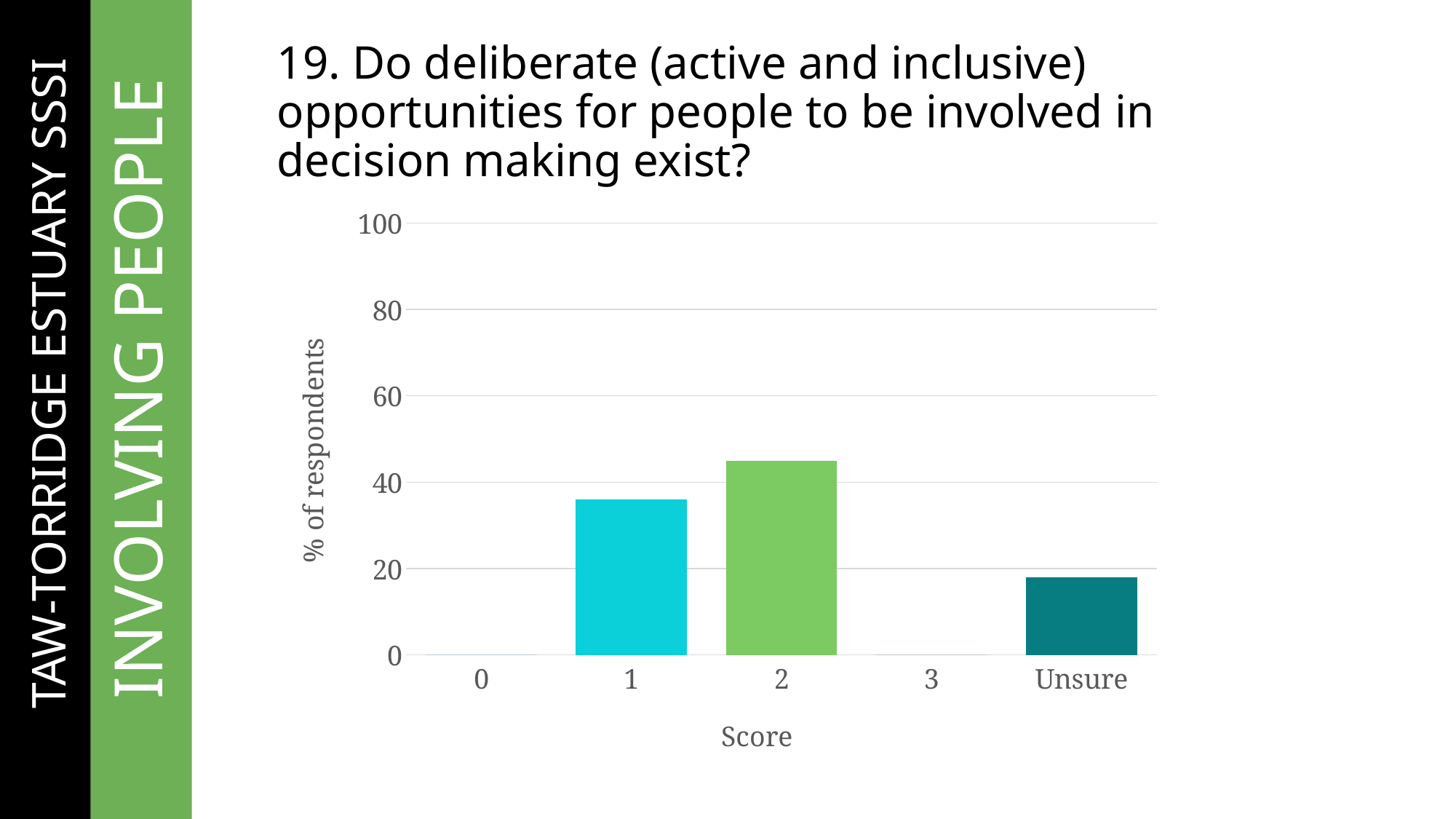
What is the label of the y axis? % of respondents Which score category has the highest percentage of respondents? 2 Is the value for score 1 greater or less than 20? greater Which is larger, the value for score 1 or the value for score 2? 2 Is the value for score 2 greater or less than 40? greater Is the value for score 1 greater or less than 40? less Which is larger, the value for score 1 or the value for Unsure? 1 What kind of chart is shown on the slide? bar chart How many score categories are shown on the x axis? 5 Which score categories have no visible bar? 0 and 3 What is the label of the x axis? Score